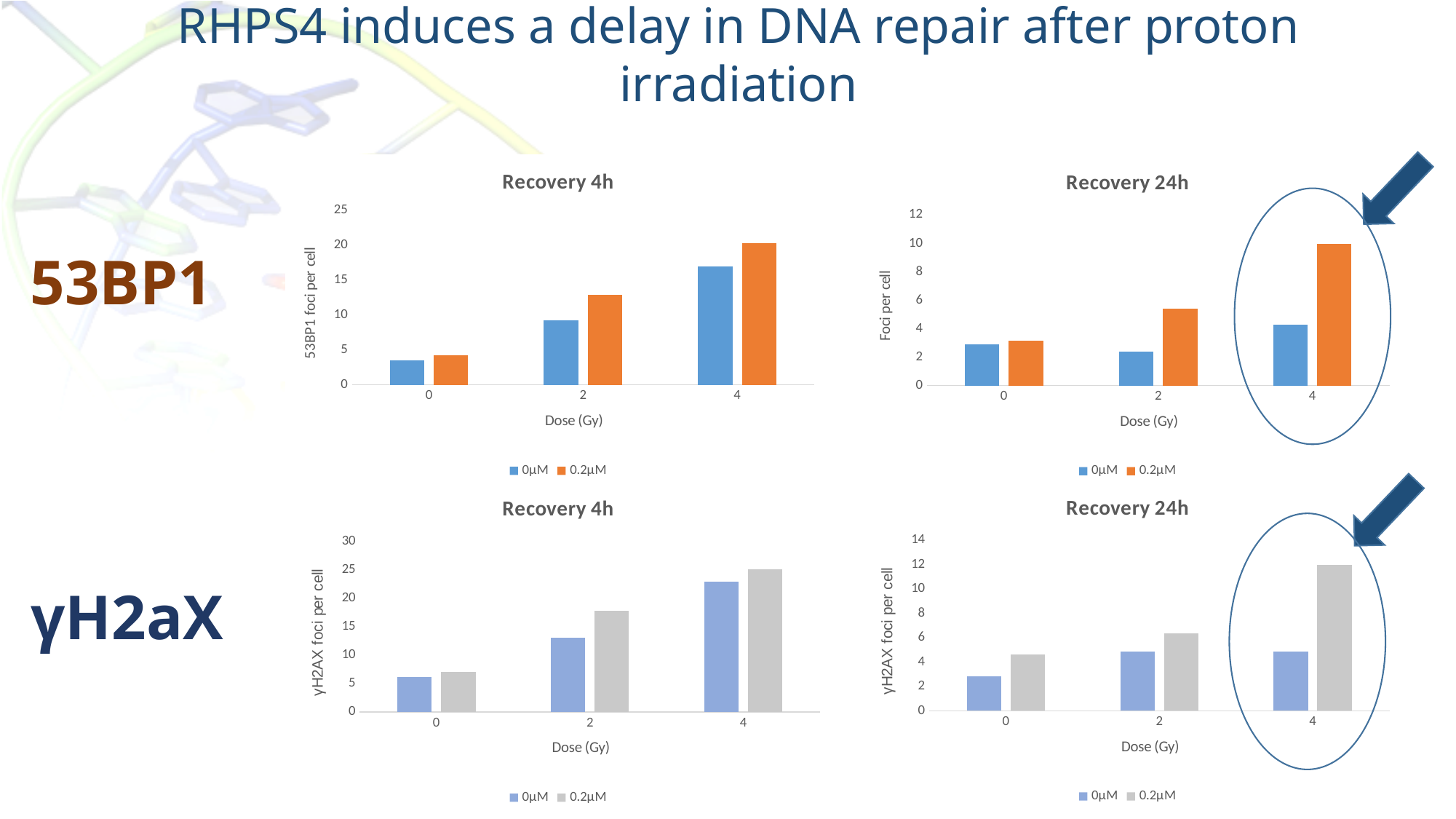
How many series does the legend of the 53BP1 Recovery 24h chart (top right) list? 2 In the γH2aX Recovery 24h chart (bottom right), is the value for 0.2μM at 4 Gy greater or less than 10? greater In the 53BP1 Recovery 4h chart (top left), is the value for 0.2μM at 4 Gy greater or less than 15? greater In the 53BP1 Recovery 24h chart (top right), at 4 Gy, which series has the larger value, 0μM or 0.2μM? 0.2μM What kind of chart is the 53BP1 Recovery 4h chart (top left)? bar chart In the γH2aX Recovery 4h chart (bottom left), at which dose is the 0.2μM bar highest? 4 What is the y-axis label of the 53BP1 Recovery 4h chart (top left)? 53BP1 foci per cell In the 53BP1 Recovery 24h chart (top right), is the value for 0.2μM at 4 Gy greater or less than 8? greater How many dose categories are shown on the x axis of the γH2aX Recovery 4h chart (bottom left)? 3 In the 53BP1 Recovery 4h chart (top left), do the 0.2μM values rise or fall as dose increases? rise In the 53BP1 Recovery 24h chart (top right), at which dose is the 0.2μM bar highest? 4